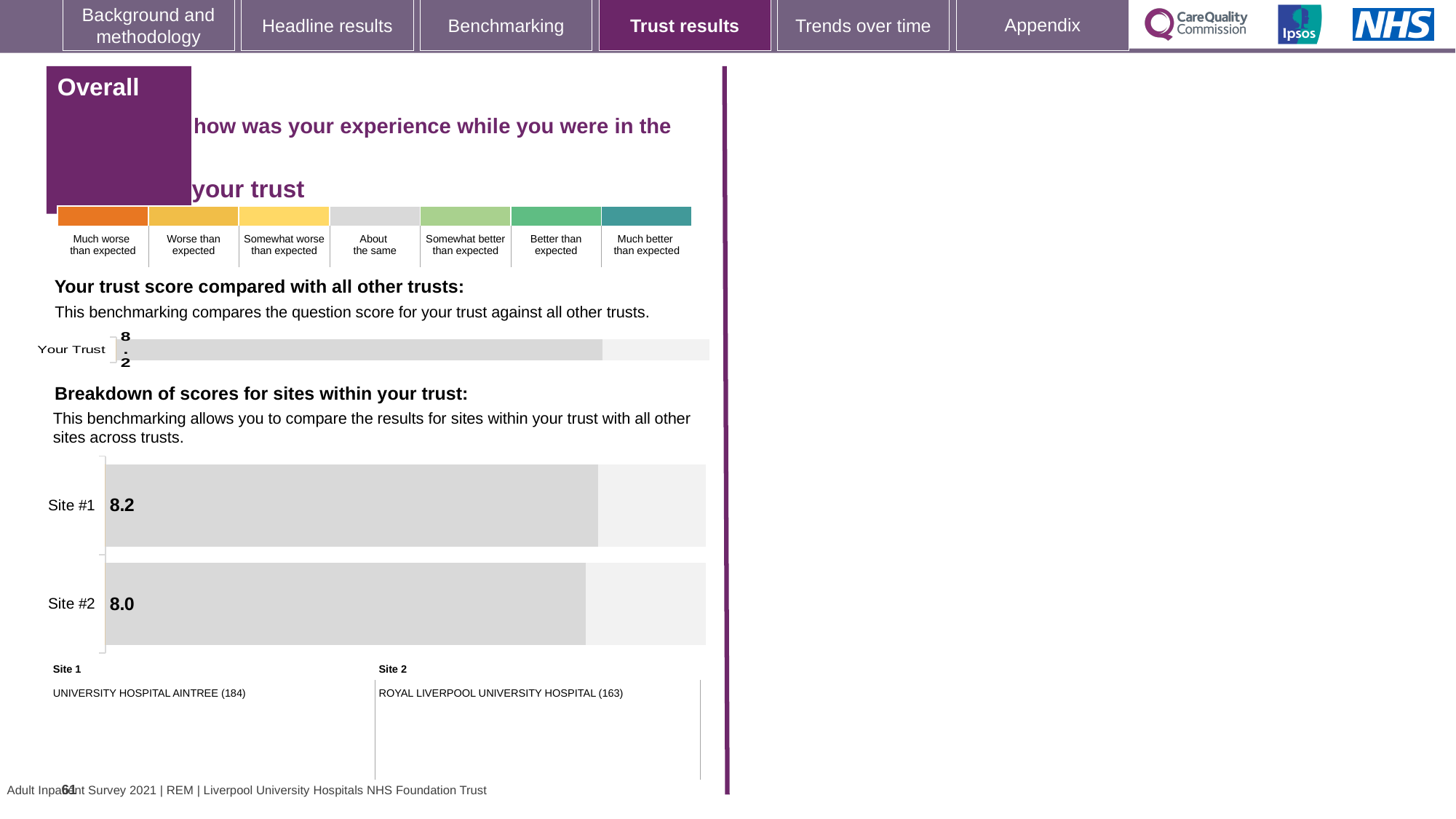
In the 'Breakdown of scores for sites within your trust' chart, which site has the highest score? Site #1 What kind of chart is the 'Your trust score compared with all other trusts' chart? Bar chart How many sites are shown in the 'Breakdown of scores for sites within your trust' chart? 2 In the 'Breakdown of scores for sites within your trust' chart, what is the score for Site #2? 8.0 In the 'Breakdown of scores for sites within your trust' chart, which has a larger score, Site #1 or Site #2? Site #1 In the 'Breakdown of scores for sites within your trust' chart, what is the difference between the scores for Site #1 and Site #2? 0.2 In the 'Your trust score compared with all other trusts' chart, what is the score for Your Trust? 8.2 In the 'Breakdown of scores for sites within your trust' chart, which site has the lowest score? Site #2 How many categories are plotted in the 'Your trust score compared with all other trusts' chart? 1 What kind of chart is the 'Breakdown of scores for sites within your trust' chart? Bar chart According to the site key below the 'Breakdown of scores for sites within your trust' chart, which hospital is Site 1? UNIVERSITY HOSPITAL AINTREE (184) In the 'Breakdown of scores for sites within your trust' chart, what is the score for Site #1? 8.2